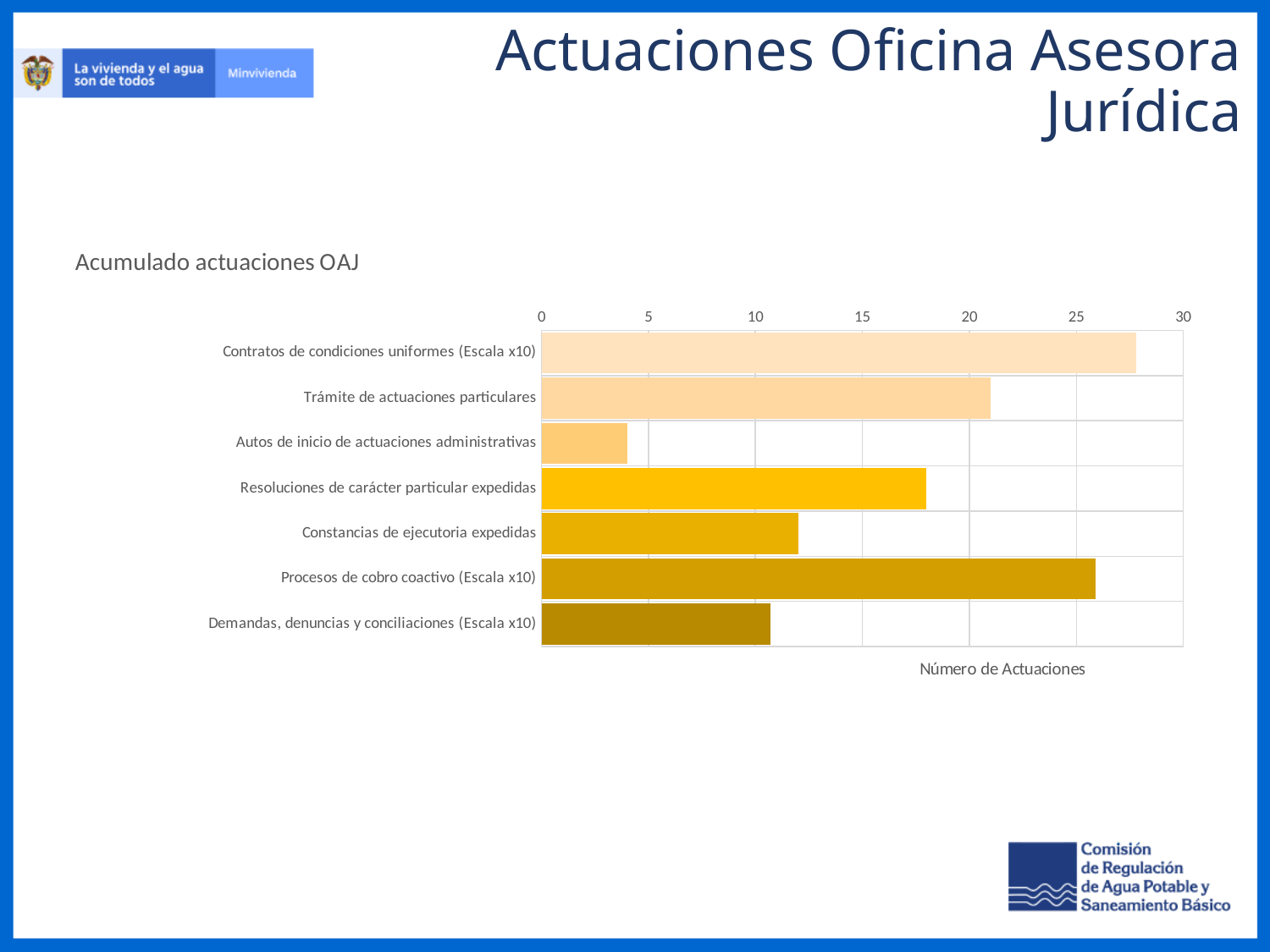
Is the value for Resoluciones de carácter particular expedidas greater or less than 20? less Is the value for Autos de inicio de actuaciones administrativas greater or less than 5? less Which is larger, the value for Trámite de actuaciones particulares or the value for Resoluciones de carácter particular expedidas? Trámite de actuaciones particulares Which is larger, the value for Constancias de ejecutoria expedidas or the value for Autos de inicio de actuaciones administrativas? Constancias de ejecutoria expedidas Is the value for Contratos de condiciones uniformes (Escala x10) greater or less than 25? greater What kind of chart is shown on the slide? Bar chart Which category has the lowest value in the chart? Autos de inicio de actuaciones administrativas What is the label of the horizontal axis of the chart? Número de Actuaciones How many categories are plotted in the chart? 7 Which category has the highest value in the chart? Contratos de condiciones uniformes (Escala x10) What is the title of the chart? Acumulado actuaciones OAJ